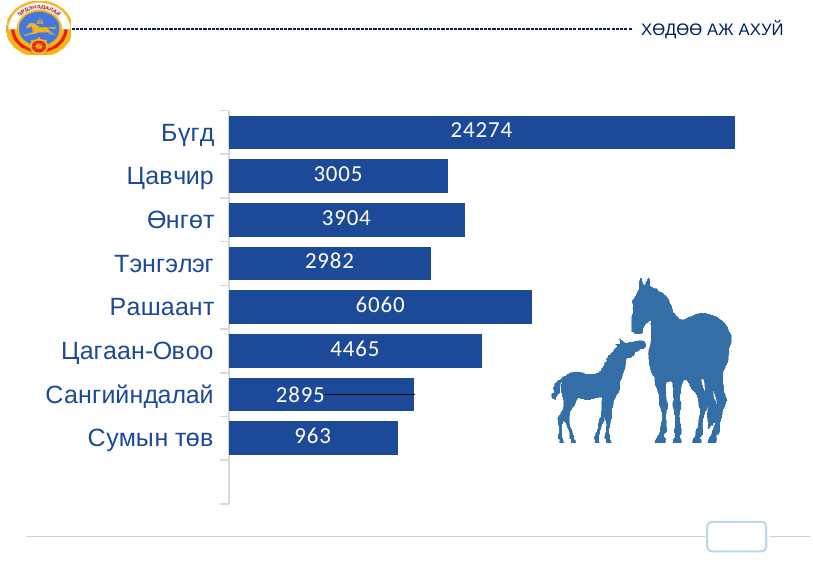
What is the value for Рашаант? 6060 What is the difference between the values for Цавчир and Тэнгэлэг? 23 Which is larger, the value for Өнгөт or the value for Цавчир? Өнгөт What is the value for Сангийндалай? 2895 What is the value for Цагаан-Овоо? 4465 What is the value for Бүгд? 24274 Which category has the lowest value? Сумын төв Excluding the total bar Бүгд, which category has the highest value? Рашаант What is the value for Сумын төв? 963 What is the difference between the values for Рашаант and Цагаан-Овоо? 1595 How many bars are shown in the chart? 8 What type of chart is shown on the slide? Bar chart